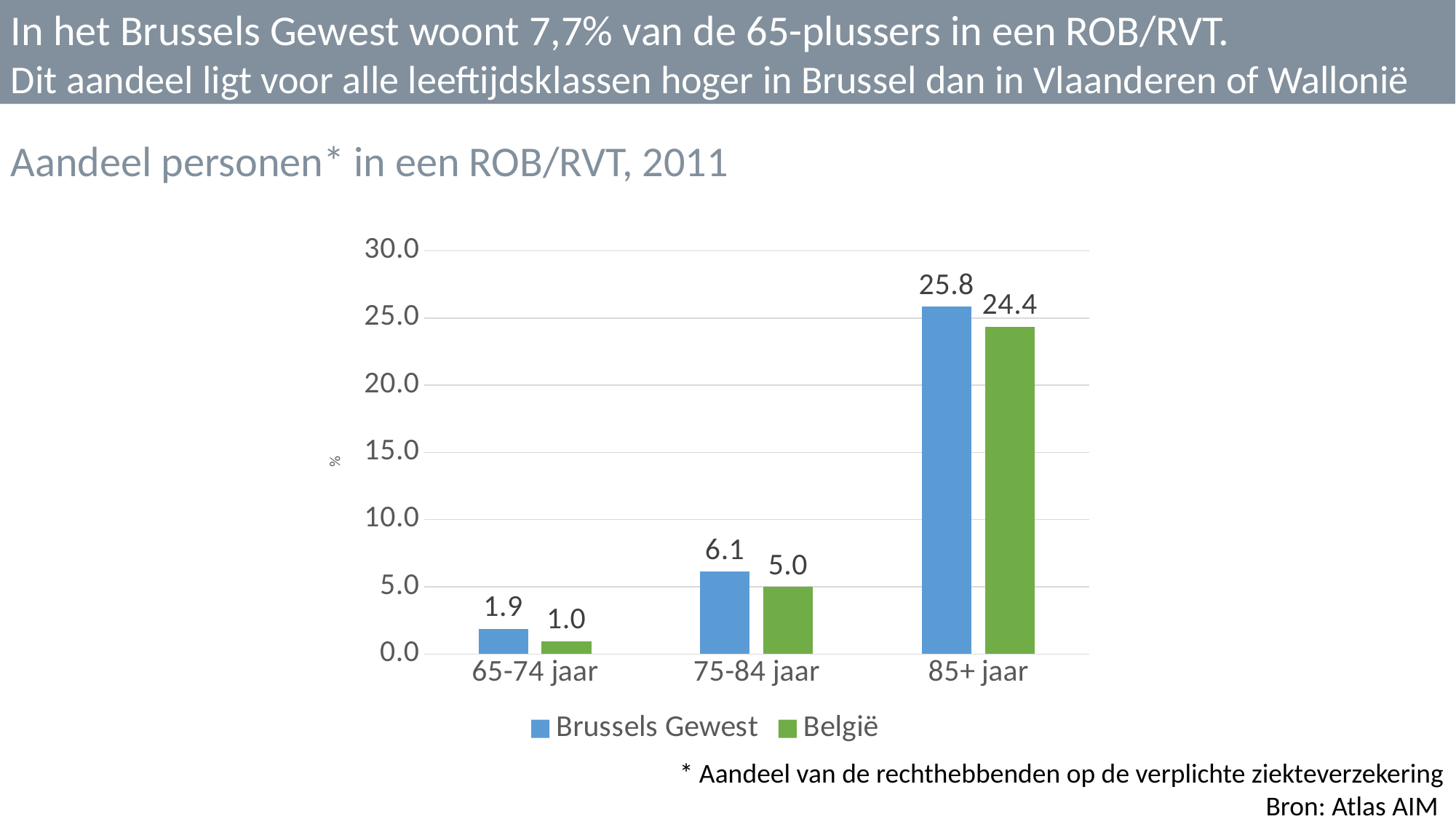
Do the values for Brussels Gewest rise or fall from 65-74 jaar to 85+ jaar? rise What is the value for België in the 85+ jaar category? 24.4 Is the value for Brussels Gewest in the 85+ jaar category greater or less than 25.0? greater How many series does the legend list? 2 What kind of chart is shown on the slide? bar chart What is the difference between Brussels Gewest and België in the 85+ jaar category? 1.4 What is the value for België in the 75-84 jaar category? 5.0 How many age categories are shown on the x axis? 3 Which age category has the highest value for Brussels Gewest? 85+ jaar Which age category has the lowest value for België? 65-74 jaar Which is larger in the 75-84 jaar category: Brussels Gewest or België? Brussels Gewest What is the value for Brussels Gewest in the 65-74 jaar category? 1.9